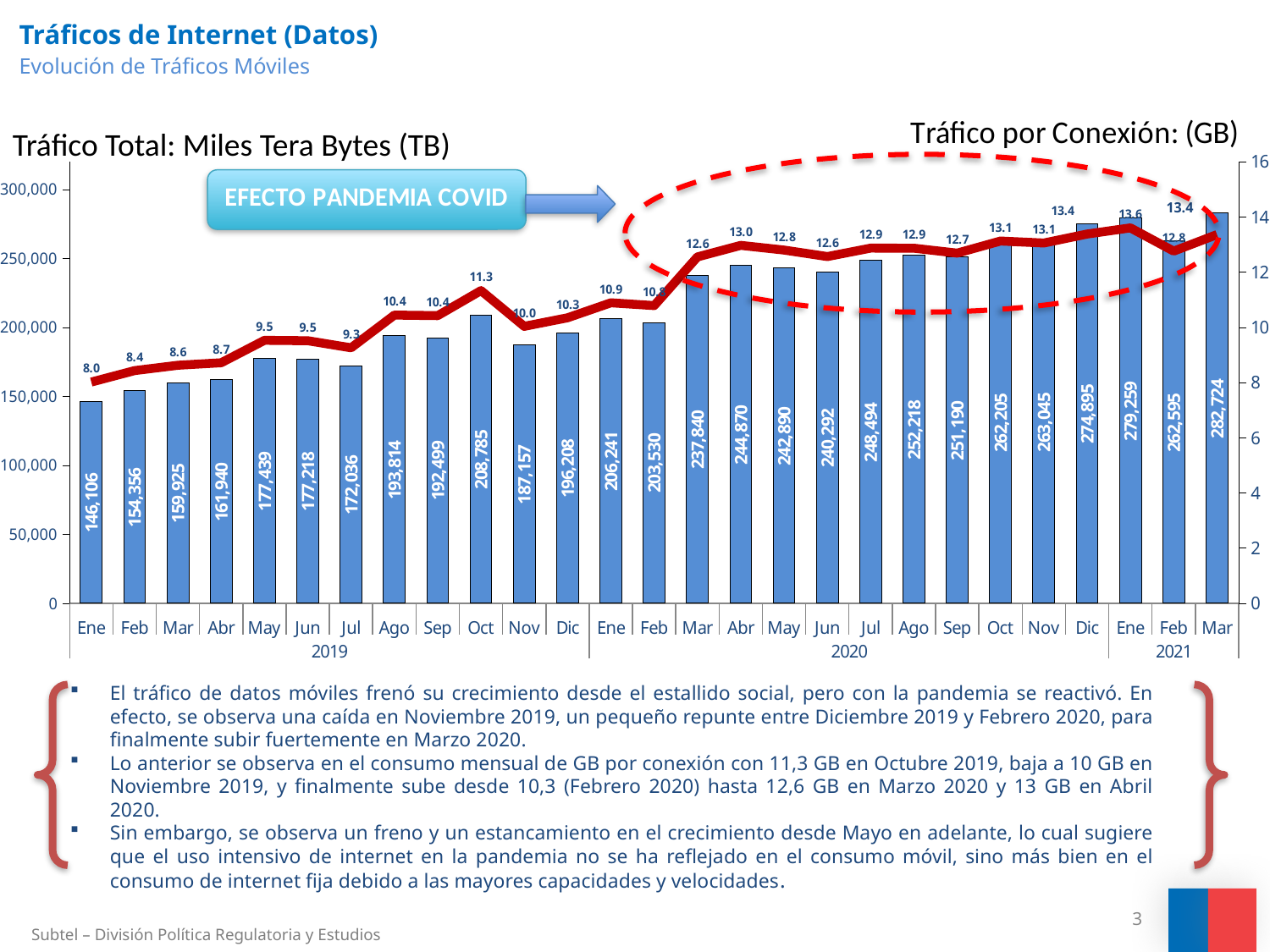
Which has the larger total traffic bar, Nov 2019 or Dic 2019? Dic 2019 What is the total mobile traffic (Miles TB) shown for Mar 2021? 282,724 Which month has the highest total traffic bar? Mar 2021 How many monthly bars are plotted in the chart? 27 What is the difference in traffic per connection (GB) between Abr 2020 and Mar 2020? 0.4 What is the total mobile traffic (Miles TB) shown for Oct 2019? 208,785 What is the traffic per connection (GB) shown for Oct 2019? 11.3 What is the difference in total traffic between Mar 2020 and Feb 2020? 34,310 Which month has the lowest total traffic bar? Ene 2019 Does the total traffic generally rise or fall from Ene 2019 to Mar 2021? Rise What is the traffic per connection (GB) shown for Ene 2021? 13.6 What kind of chart is used on the slide? Bar chart with a line